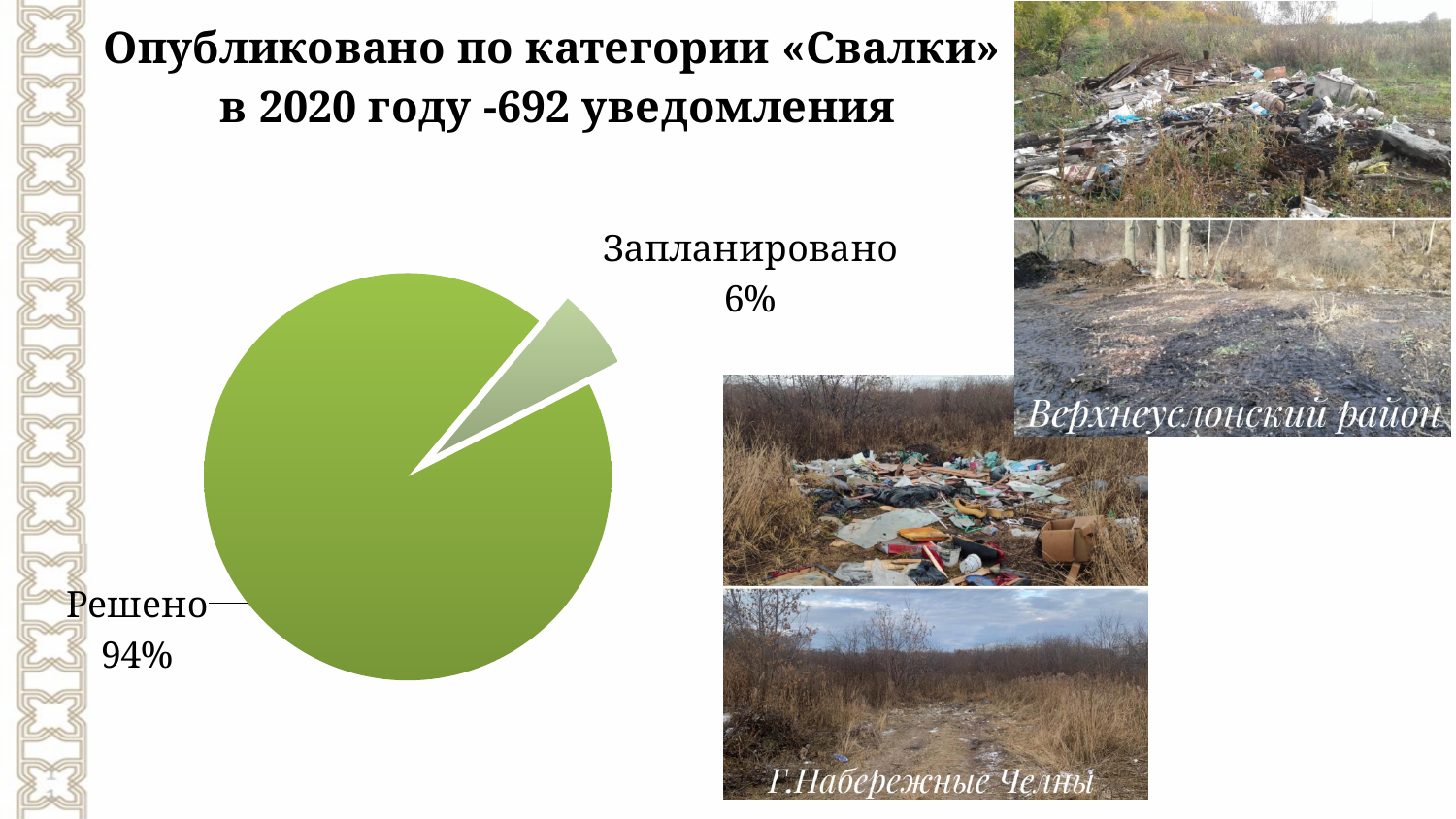
Which is larger, the "Решено" slice or the "Запланировано" slice? Решено What share of the pie does the "Решено" slice represent? 94% Which slice of the pie chart is the smallest? Запланировано Is the share for "Решено" greater or less than 50%? greater Which slice of the pie chart is the largest? Решено How many slices does the pie chart have? 2 What is the difference in percentage points between the "Решено" and "Запланировано" slices? 88 What colour is the "Решено" slice of the pie chart? green What share of the pie does the "Запланировано" slice represent? 6% What kind of chart is shown on the slide? pie chart According to the slide title, how many notifications were published in the "Свалки" category in 2020? 692